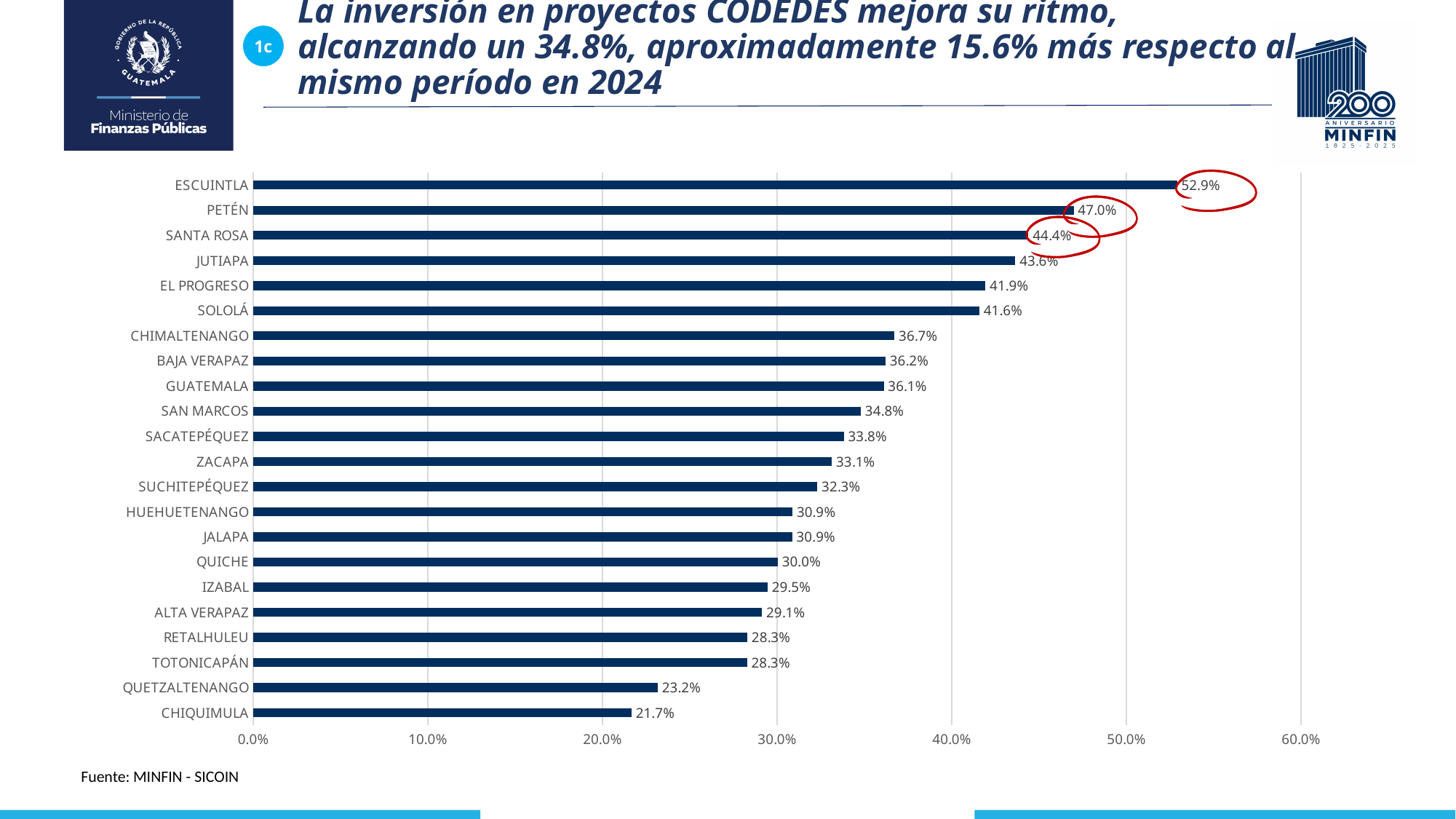
Is the value for SANTA ROSA greater or less than 40.0%? greater Which department has the lowest value? CHIQUIMULA How many departments are shown in the chart? 22 What kind of chart is shown on the slide? bar chart What is the value for ESCUINTLA? 52.9% What is the source cited below the chart? MINFIN - SICOIN What is the difference between the values for SOLOLÁ and CHIQUIMULA? 19.9% What is the value for SAN MARCOS? 34.8% What is the difference between the values for ESCUINTLA and PETÉN? 5.9% What is the value for QUETZALTENANGO? 23.2% Which department has the highest value? ESCUINTLA Which is larger, the value for JUTIAPA or the value for EL PROGRESO? JUTIAPA